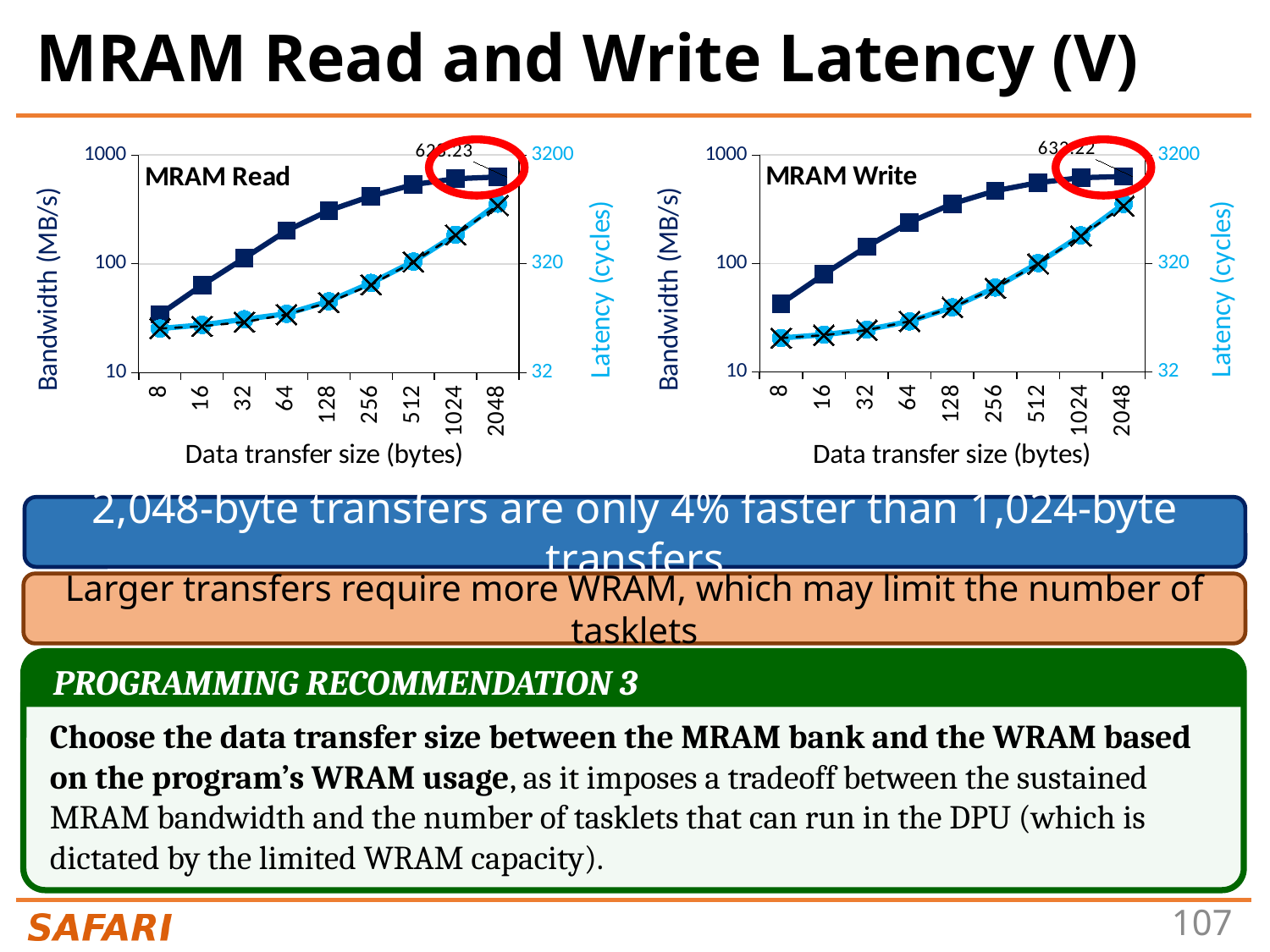
In the MRAM Read chart, is the latency for a 2048-byte transfer greater or less than 320 cycles? greater What kind of chart is the MRAM Read chart? line chart In the MRAM Write chart, which data transfer size has the lowest bandwidth? 8 In the MRAM Write chart, is the bandwidth for a 64-byte transfer greater or less than 100 MB/s? greater In the MRAM Write chart, is the bandwidth for an 8-byte transfer greater or less than 100 MB/s? less In the MRAM Read chart, does bandwidth rise or fall as the data transfer size increases? rises In the MRAM Read chart, which is larger, the bandwidth at 128 bytes or at 8 bytes? 128 bytes How many data transfer sizes are shown on the x axis of the MRAM Write chart? 9 What is the x-axis title of the MRAM Write chart? Data transfer size (bytes)